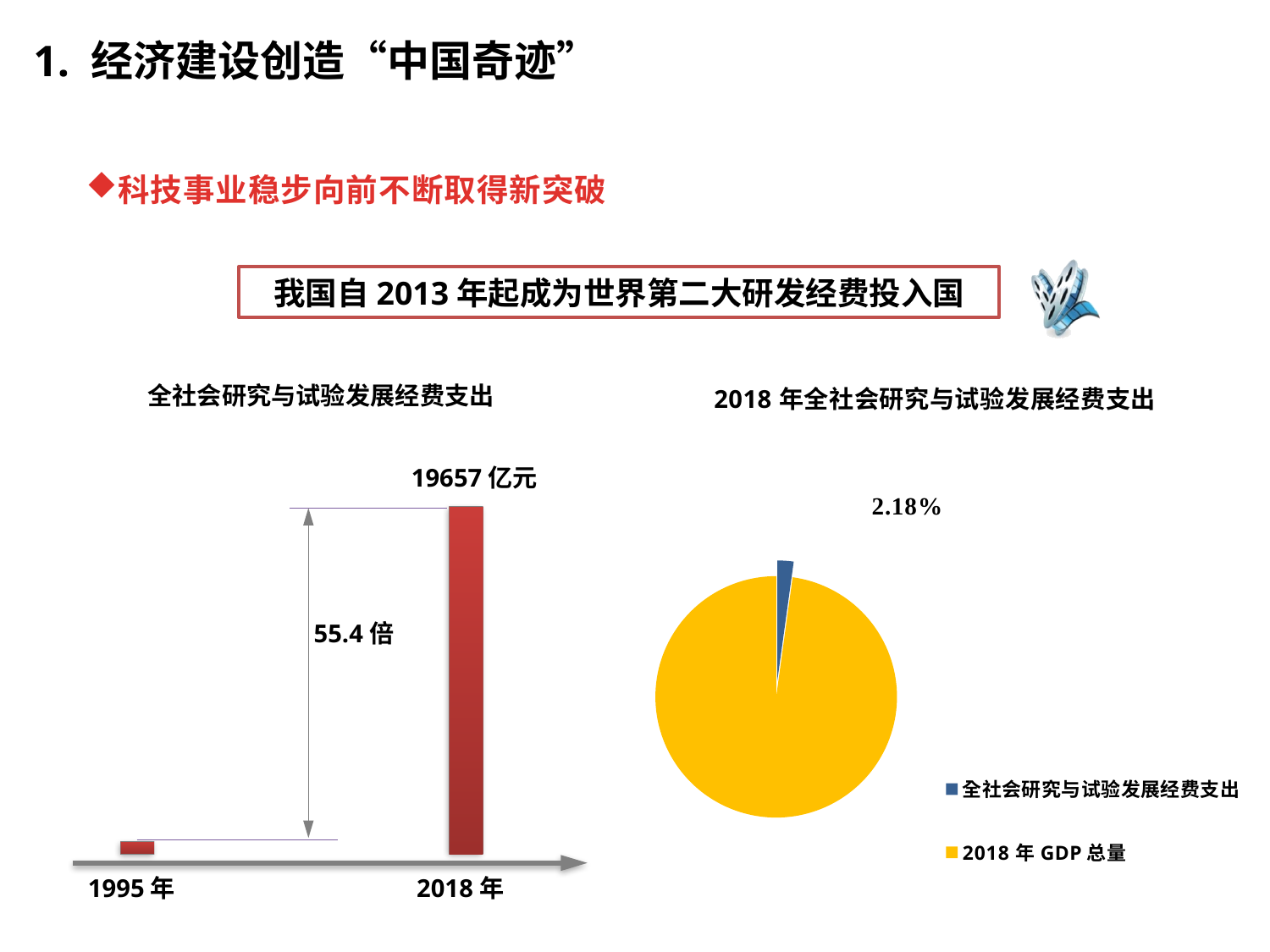
In the bar chart 全社会研究与试验发展经费支出, does the value rise or fall from 1995年 to 2018年? rise In the pie chart 2018年全社会研究与试验发展经费支出, what colour is the slice for 2018年GDP总量? yellow What is the title of the chart on the left of the slide? 全社会研究与试验发展经费支出 In the bar chart 全社会研究与试验发展经费支出, by what multiple is the 2018年 value larger than the 1995年 value, according to the annotation? 55.4倍 In the pie chart 2018年全社会研究与试验发展经费支出, which slice is larger, 全社会研究与试验发展经费支出 or 2018年GDP总量? 2018年GDP总量 What kind of chart is the chart titled 2018年全社会研究与试验发展经费支出 on the right? pie chart How many entries does the legend of the pie chart 2018年全社会研究与试验发展经费支出 list? 2 How many years (categories) are plotted in the bar chart 全社会研究与试验发展经费支出? 2 In the bar chart 全社会研究与试验发展经费支出, which year has the higher value, 1995年 or 2018年? 2018年 In the pie chart 2018年全社会研究与试验发展经费支出, what share does 全社会研究与试验发展经费支出 represent? 2.18% What kind of chart is the chart titled 全社会研究与试验发展经费支出 on the left? bar chart In the bar chart 全社会研究与试验发展经费支出, what is the value shown for 2018年? 19657亿元